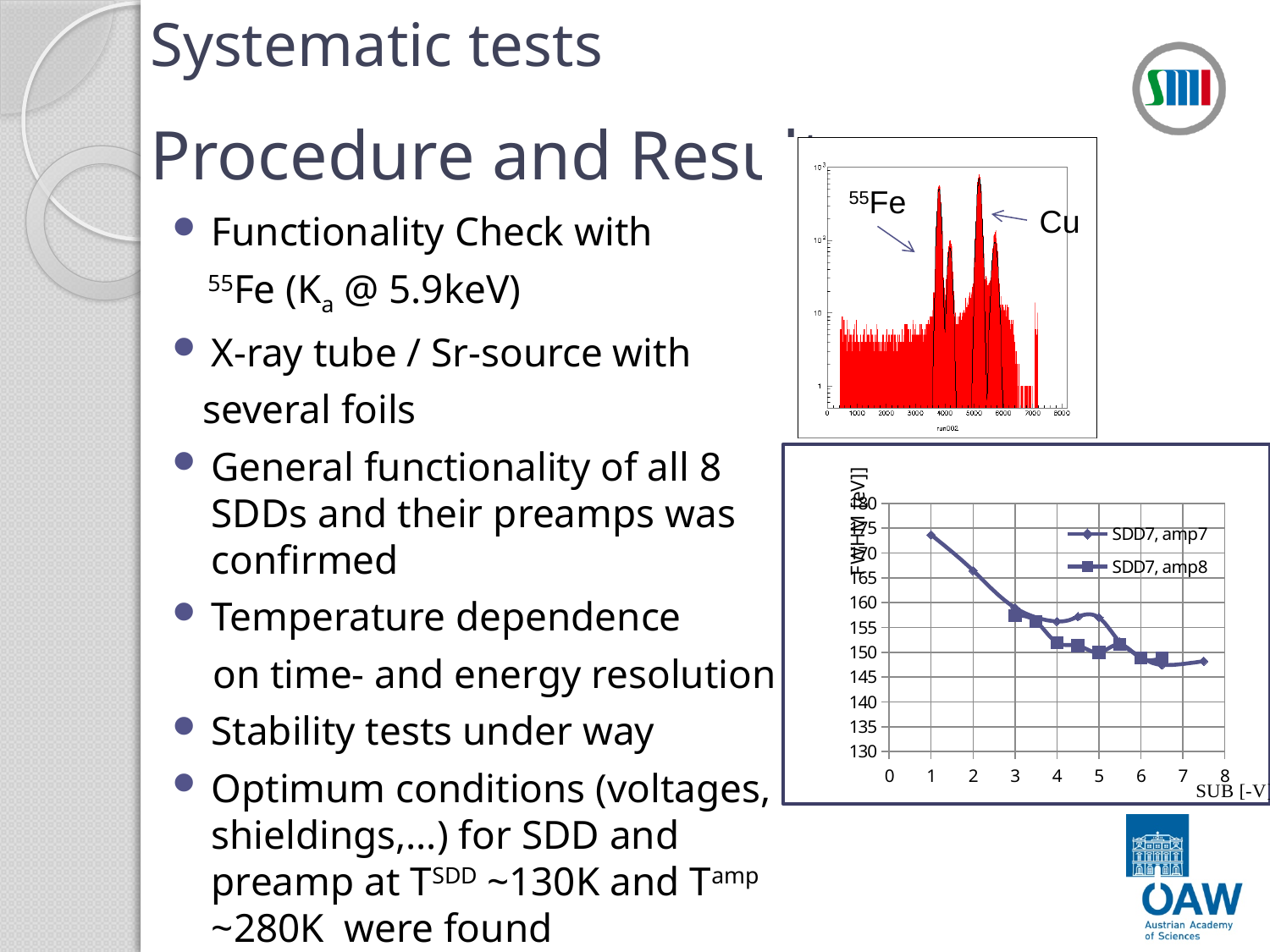
In the bottom-right chart, is the value for SDD7, amp8 at SUB = 5 greater or less than 155? less In the bottom-right chart, how many series does the legend list? 2 In the bottom-right chart, is the value for SDD7, amp7 at SUB = 3 greater or less than 155? greater In the bottom-right chart, what is the label of the x axis? SUB [-V] In the bottom-right chart, do the values for SDD7, amp7 rise or fall as SUB [-V] increases? fall In the bottom-right chart, is the value for SDD7, amp7 at SUB = 2 greater or less than 170? less In the bottom-right chart, do the values for SDD7, amp8 rise or fall as SUB [-V] increases? fall In the bottom-right chart, what are the two series named in the legend? SDD7, amp7 and SDD7, amp8 What kind of chart is the bottom-right chart? line chart In the top-right spectrum chart, which two sources are labelled on the peaks? 55Fe and Cu